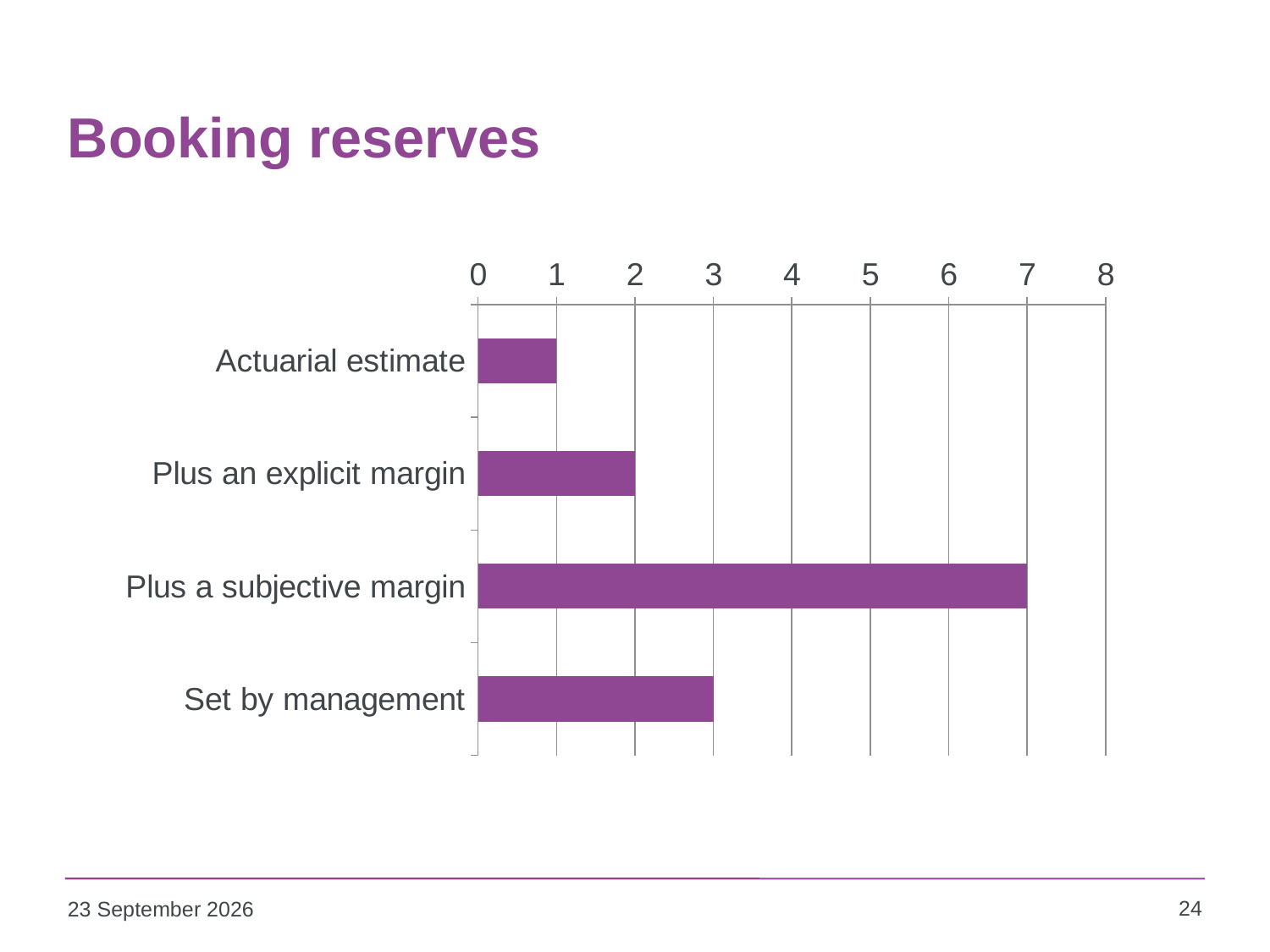
What is the value for Plus a subjective margin? 7 What kind of chart is shown on the slide? Bar chart Which is larger, the value for Set by management or the value for Plus an explicit margin? Set by management What is the difference between the values for Plus a subjective margin and Set by management? 4 What is the value for Plus an explicit margin? 2 How many categories are shown in the chart? 4 Is the value for Plus a subjective margin greater or less than 5? greater What is the value for Set by management? 3 What is the highest value shown on the chart's axis? 8 Which category has the highest value? Plus a subjective margin Which category has the lowest value? Actuarial estimate What is the value for Actuarial estimate? 1